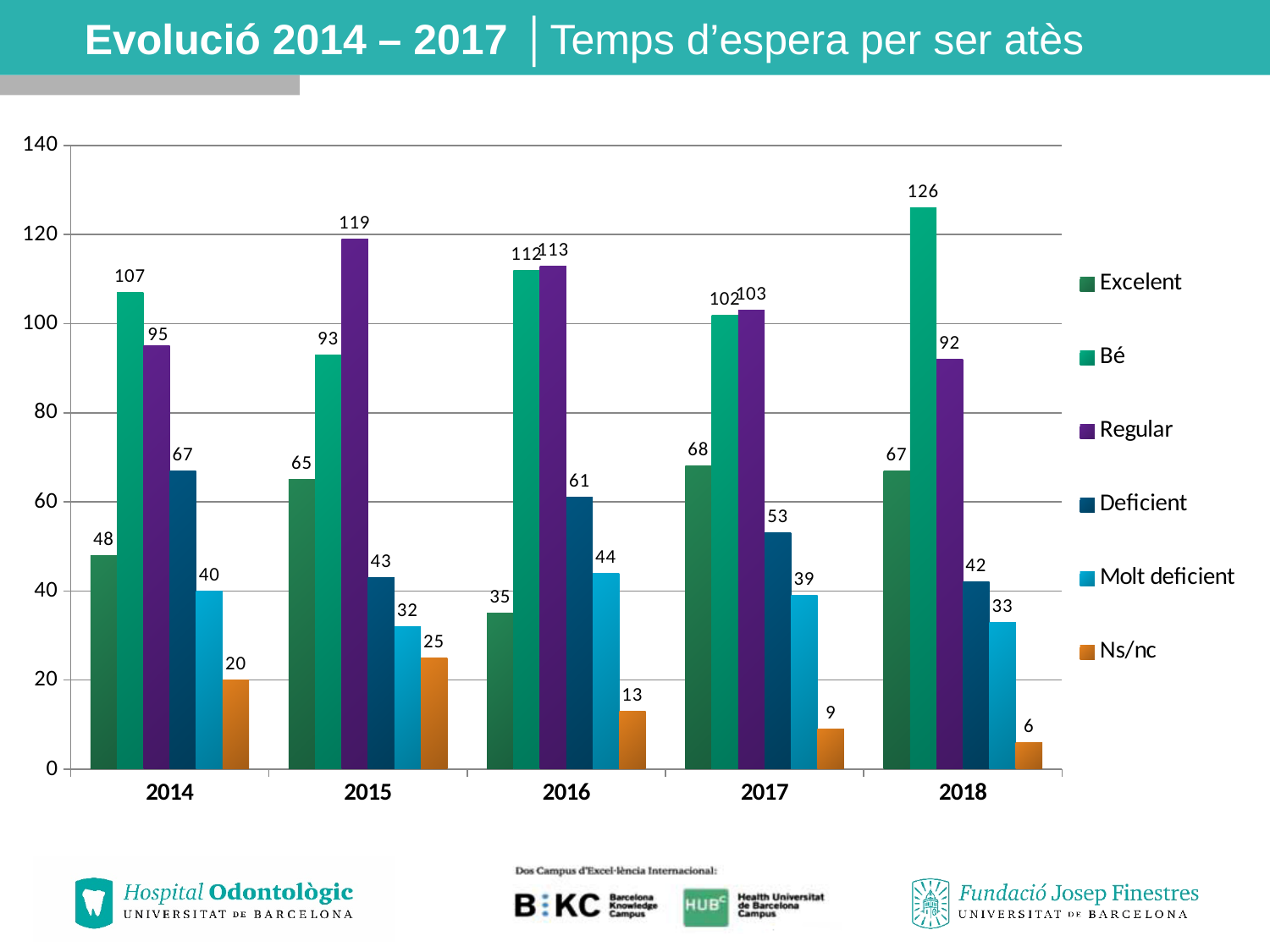
Which is larger in 2015: Bé or Regular? Regular What kind of chart is shown on the slide? bar chart What is the value for Ns/nc in 2016? 13 How many years are shown on the x axis? 5 Does the Ns/nc value rise or fall from 2015 to 2018? fall In which year is the Bé value highest? 2018 What is the value for Excelent in 2014? 48 What is the difference between the Deficient values in 2014 and 2018? 25 What is the value for Regular in 2015? 119 In which year is the Ns/nc value lowest? 2018 What is the value for Bé in 2018? 126 How many series does the legend list? 6